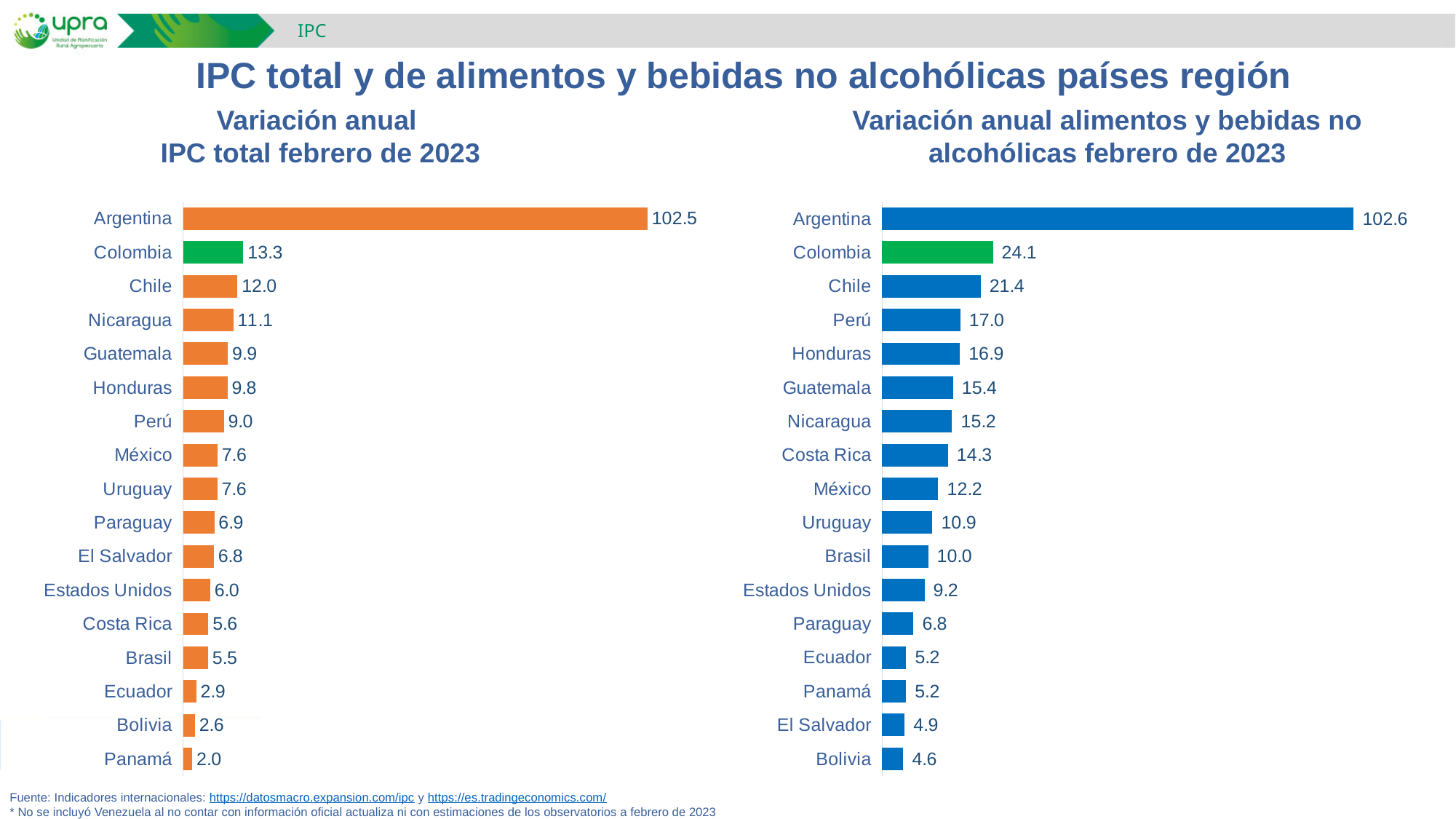
In the 'Variación anual alimentos y bebidas no alcohólicas febrero de 2023' chart, which country has the lowest value? Bolivia In the 'Variación anual alimentos y bebidas no alcohólicas febrero de 2023' chart, what is the difference between Colombia and Chile? 2.7 In the 'Variación anual IPC total febrero de 2023' chart, what is the difference between Argentina and Colombia? 89.2 How many countries are shown in the 'Variación anual IPC total febrero de 2023' chart? 17 What type of chart is the 'Variación anual alimentos y bebidas no alcohólicas febrero de 2023' chart? Bar chart In the 'Variación anual IPC total febrero de 2023' chart, what colour is the bar for Colombia? Green In the 'Variación anual IPC total febrero de 2023' chart, which country has the highest value? Argentina In the 'Variación anual alimentos y bebidas no alcohólicas febrero de 2023' chart, what is the value for Chile? 21.4 In the 'Variación anual IPC total febrero de 2023' chart, which country has the lowest value? Panamá In the 'Variación anual alimentos y bebidas no alcohólicas febrero de 2023' chart, which is larger, the value for Perú or the value for Guatemala? Perú In the 'Variación anual IPC total febrero de 2023' chart, what is the value for Colombia? 13.3 In the 'Variación anual IPC total febrero de 2023' chart, which is larger, the value for Chile or the value for Nicaragua? Chile